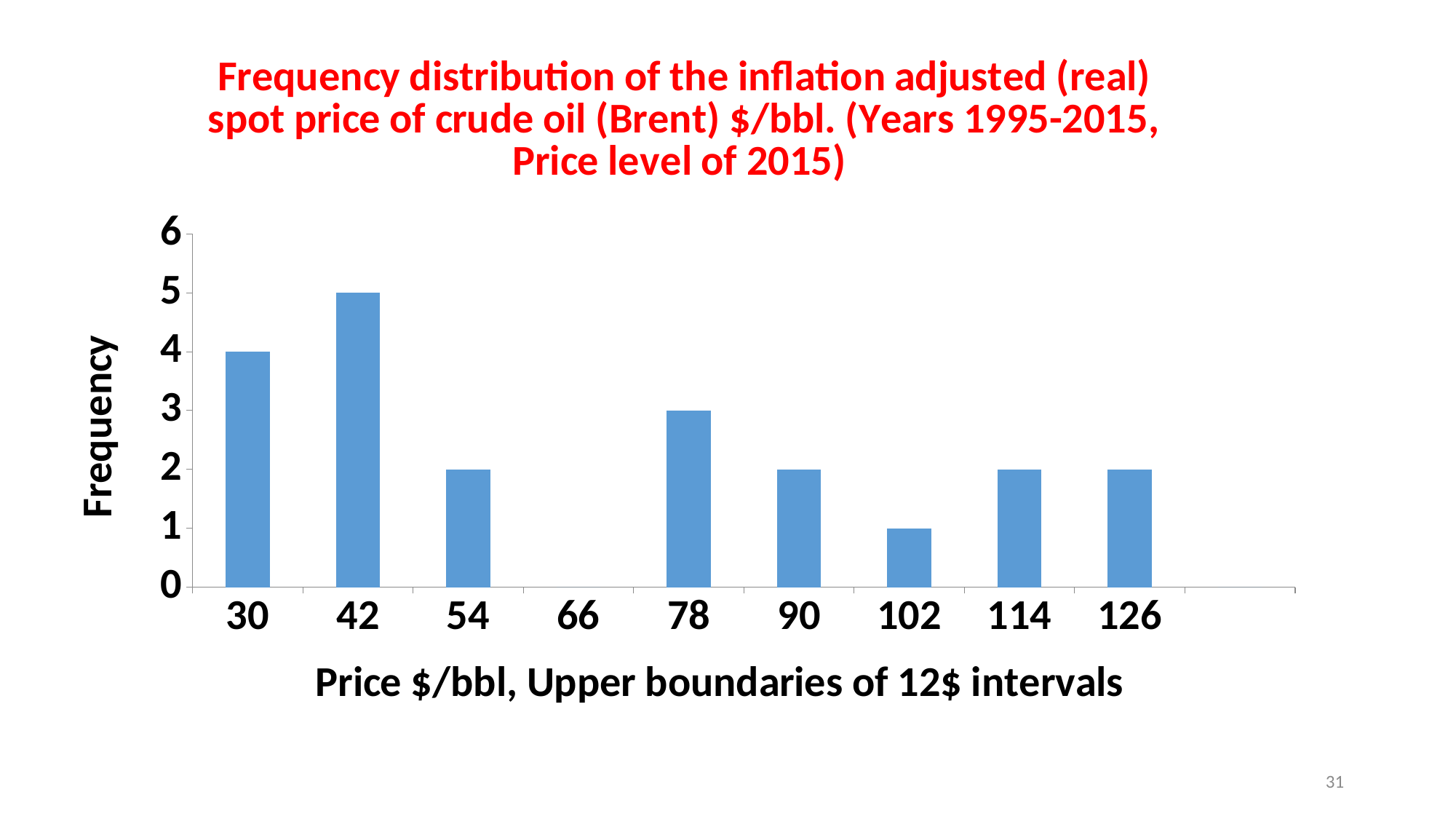
What is the difference between the frequency for 42 and the frequency for 30? 1 What is the frequency for the 78 price interval? 3 Which price interval has the highest frequency? 42 How many price intervals are labelled on the x axis? 9 Which price interval has a frequency of zero (no bar)? 66 Which has a higher frequency, the 30 interval or the 78 interval? 30 What is the label of the horizontal axis? Price $/bbl, Upper boundaries of 12$ intervals What is the frequency for the 30 price interval? 4 What kind of chart is shown on the slide? Bar chart What is the frequency for the 42 price interval? 5 What is the label of the vertical axis? Frequency What is the frequency for the 102 price interval? 1